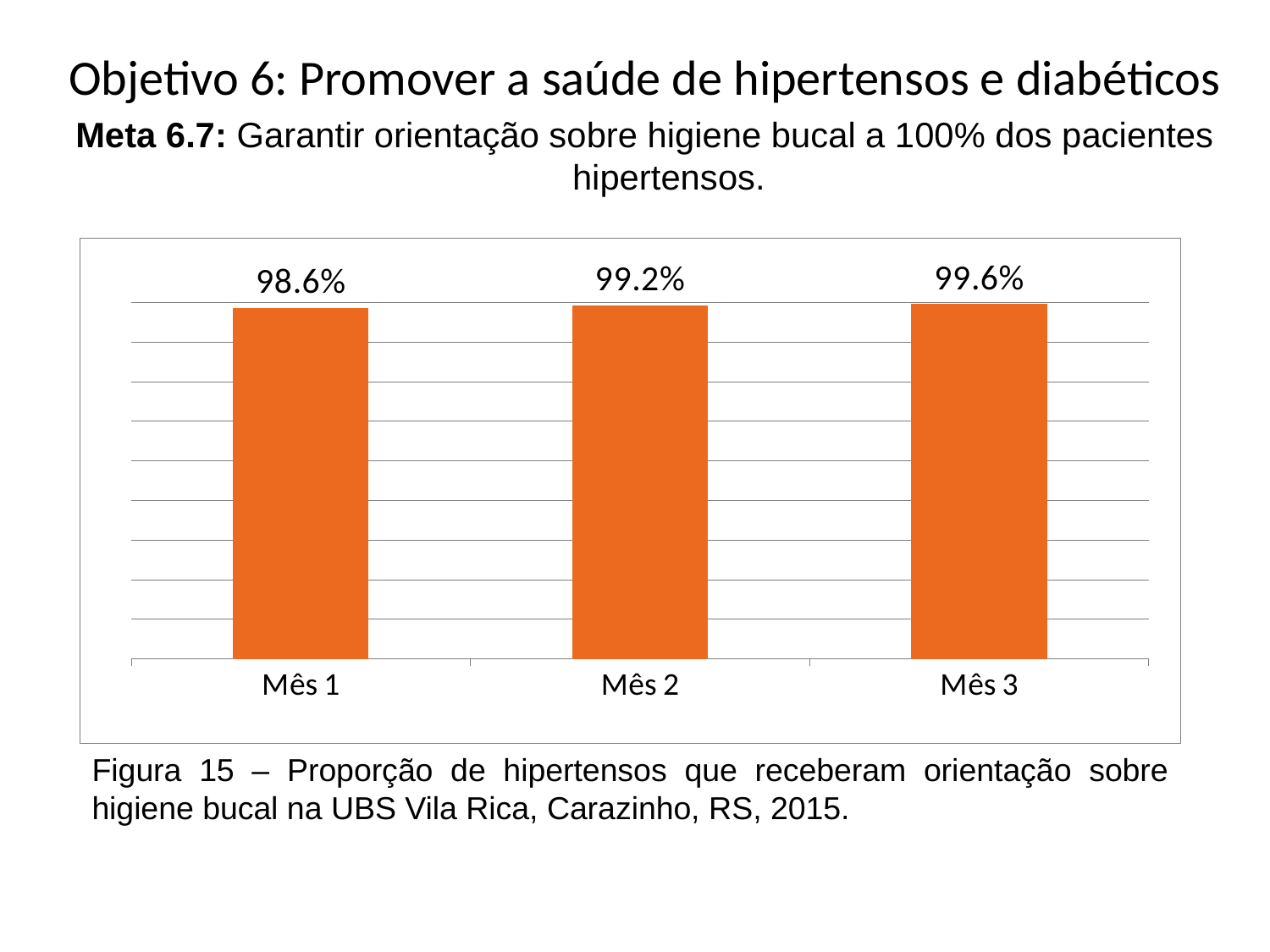
What is the value for Mês 2? 99.2% How many months are shown on the x axis? 3 Which month has the highest value? Mês 3 What is the value for Mês 1? 98.6% What is the difference between the values for Mês 2 and Mês 1? 0.6% Which is larger, the value for Mês 2 or the value for Mês 3? Mês 3 Do the values rise or fall from Mês 1 to Mês 3? Rise What is the difference between the values for Mês 3 and Mês 1? 1.0% What colour are the bars in the chart? Orange What kind of chart is shown on the slide? Bar chart Which month has the lowest value? Mês 1 What is the value for Mês 3? 99.6%